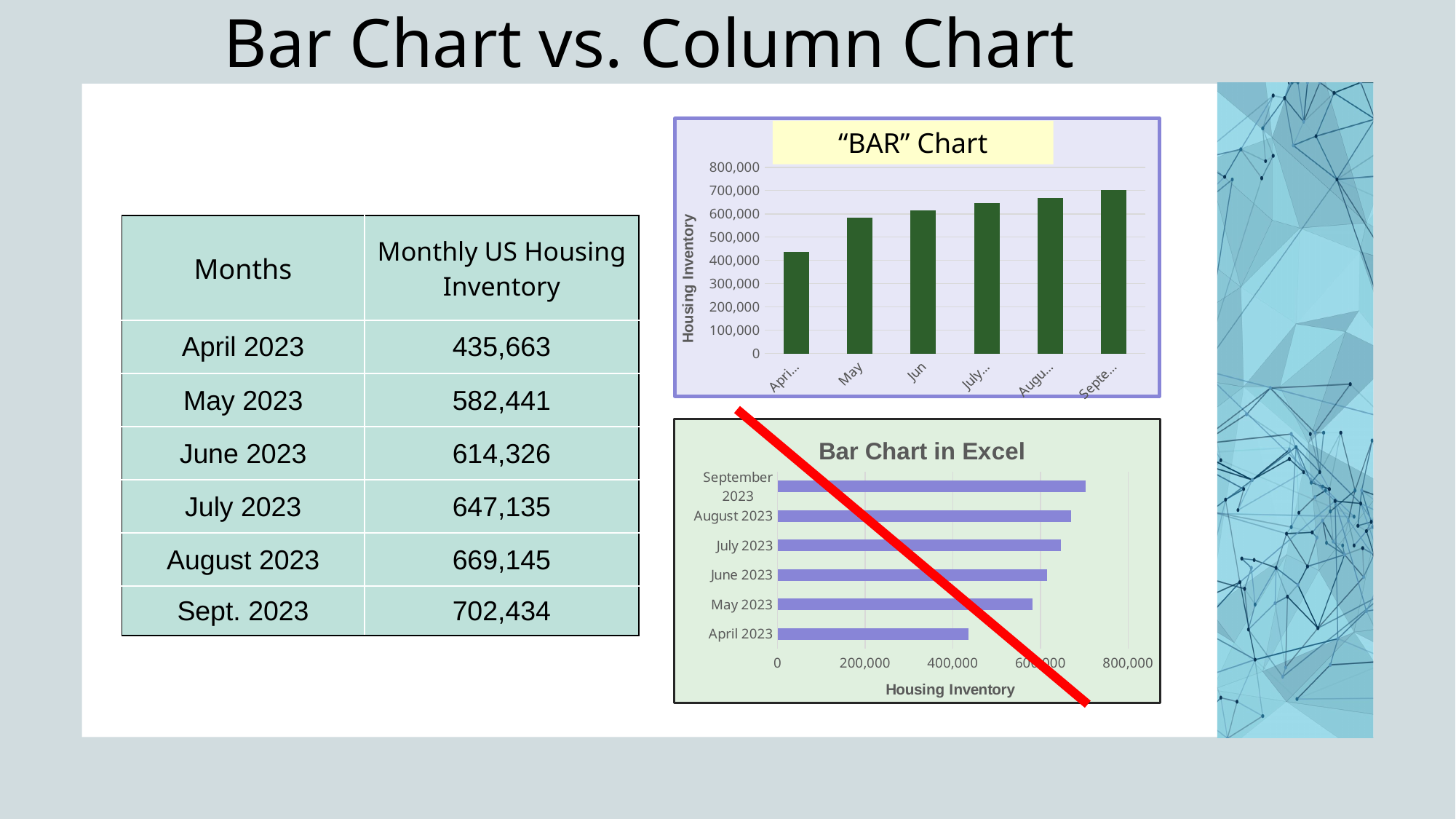
In the "Bar Chart in Excel", which month has the longest bar? September 2023 In the "Bar Chart in Excel", how many categories are shown on the vertical axis? 6 What kind of chart is the "BAR" Chart at the top right? bar chart In the "BAR" Chart, is the value for May greater or less than 500,000? greater In the "Bar Chart in Excel", is the value for September 2023 greater or less than 800,000? less In the "BAR" Chart, which is larger, the value for April or the value for June? June In the "Bar Chart in Excel", is the value for April 2023 greater or less than 600,000? less In the "BAR" Chart, do the values rise or fall from April to September? rise In the "BAR" Chart, how many bars are plotted? 6 What is the label on the vertical axis of the "BAR" Chart? Housing Inventory What kind of chart is the "Bar Chart in Excel" at the bottom right? bar chart In the "Bar Chart in Excel", which month has the shortest bar? April 2023